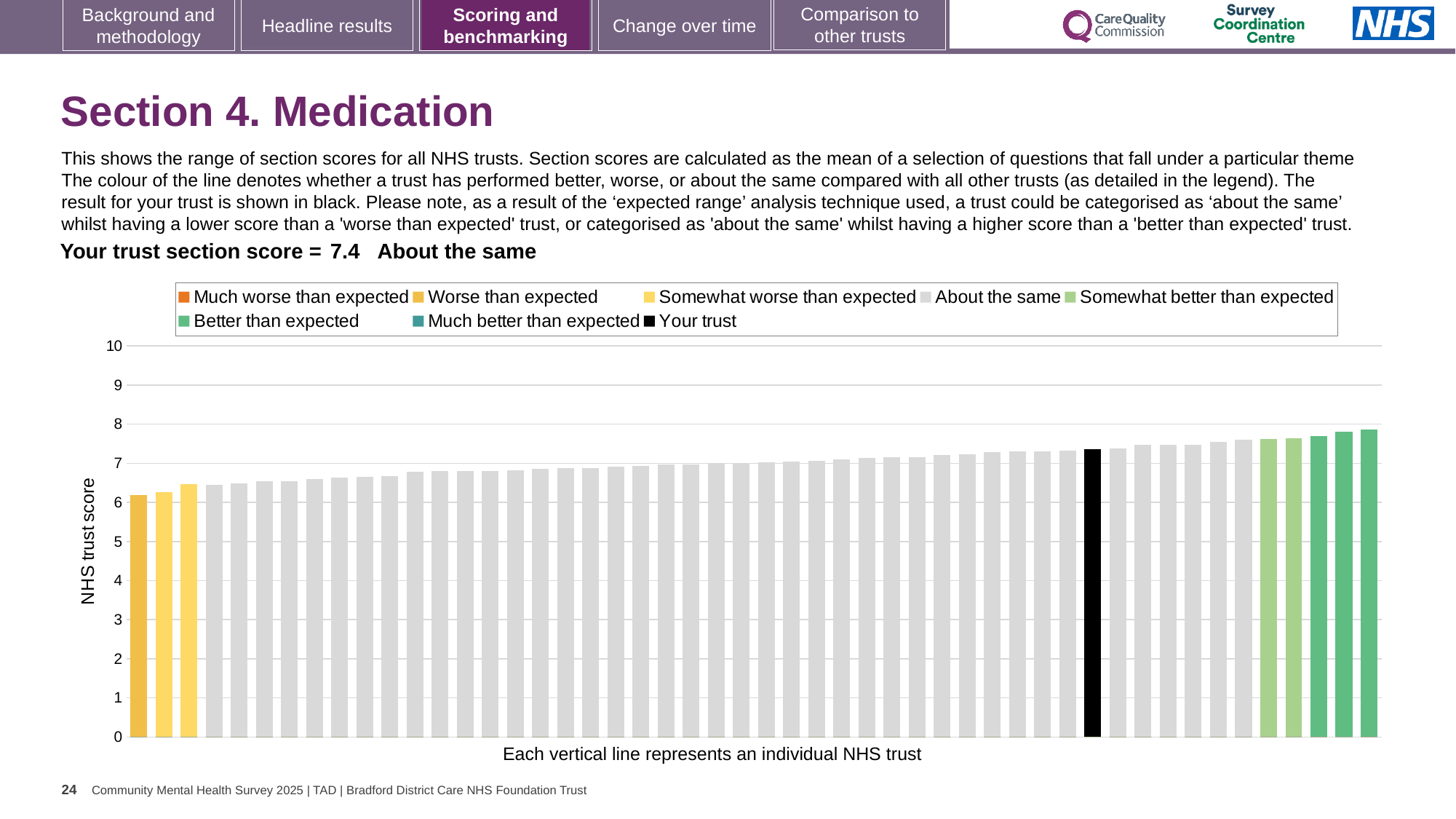
Is the value of the leftmost (lowest) bar greater or less than 7? less Is the value of the black bar (your trust) greater or less than 8? less Is the value of the rightmost (highest) bar greater or less than 8? less What is the label on the vertical axis of the chart? NHS trust score What colour is used for the bar representing your trust? black Which category is your trust's section score placed in? About the same What is the section score for your trust shown on the slide? 7.4 How many entries does the chart legend list? 8 Do the bar values rise or fall from left to right along the x axis? rise What kind of chart is shown on the slide? bar chart What is the highest value shown on the vertical axis? 10